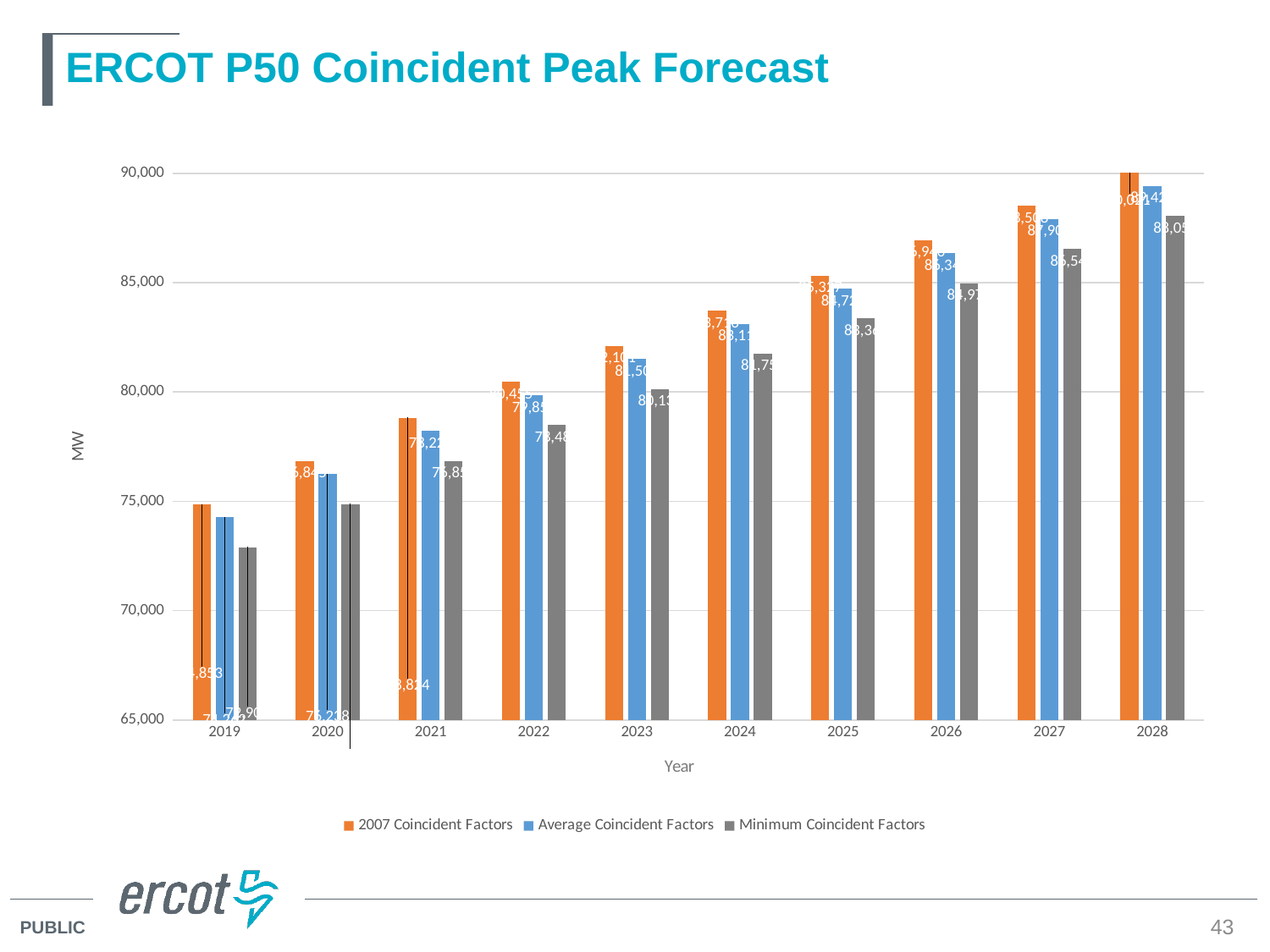
In which year is the Minimum Coincident Factors bar the lowest? 2019 Is the Minimum Coincident Factors value for 2028 greater or less than 85,000? greater In which year is the 2007 Coincident Factors bar the highest? 2028 Do the 2007 Coincident Factors values rise or fall from 2019 to 2028? Rise Is the Minimum Coincident Factors value for 2019 greater or less than 75,000? less Is the 2007 Coincident Factors value for 2021 greater or less than 75,000? greater What kind of chart is shown on the slide? Bar chart How many series does the legend list? 3 How many years are shown on the x axis? 10 In 2025, which is larger: the Average Coincident Factors value or the Minimum Coincident Factors value? Average Coincident Factors What is the label on the vertical axis? MW